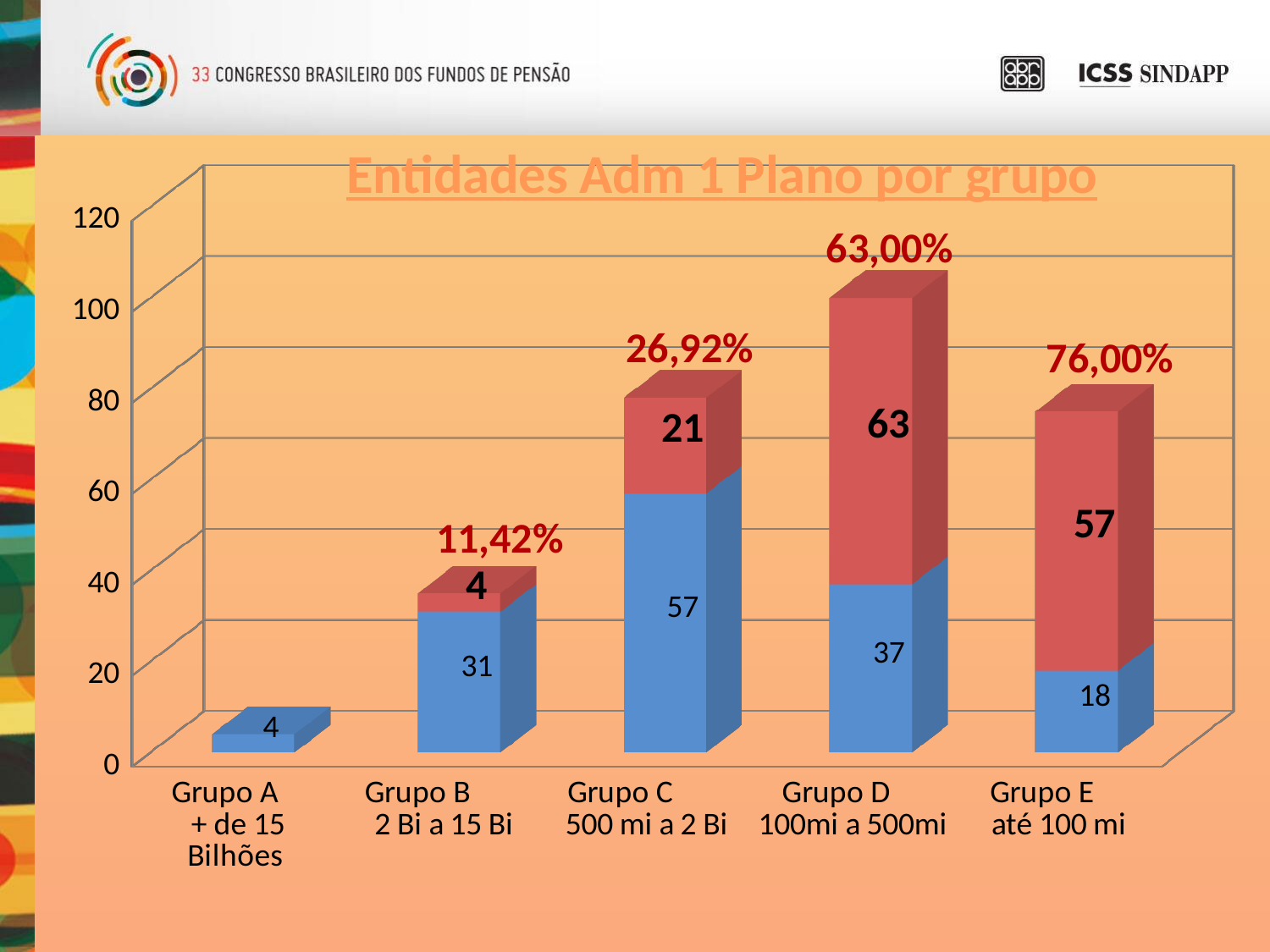
What percentage is shown above the bar for Grupo B (2 Bi a 15 Bi)? 11,42% What is the value of the red segment for Grupo D (100mi a 500mi)? 63 Which group has the largest red segment? Grupo D What is the value of the blue segment for Grupo C (500 mi a 2 Bi)? 57 What is the title of the chart? Entidades Adm 1 Plano por grupo Which is larger, the red segment of Grupo D or the red segment of Grupo E? Grupo D What is the total height of the stacked bar for Grupo D (100mi a 500mi)? 100 How many groups are shown on the x axis? 5 What is the difference between the blue segment of Grupo C and the blue segment of Grupo D? 20 What kind of chart is shown on the slide? Stacked bar chart Which group has the smallest blue segment? Grupo A What percentage is shown above the bar for Grupo E (até 100 mi)? 76,00%